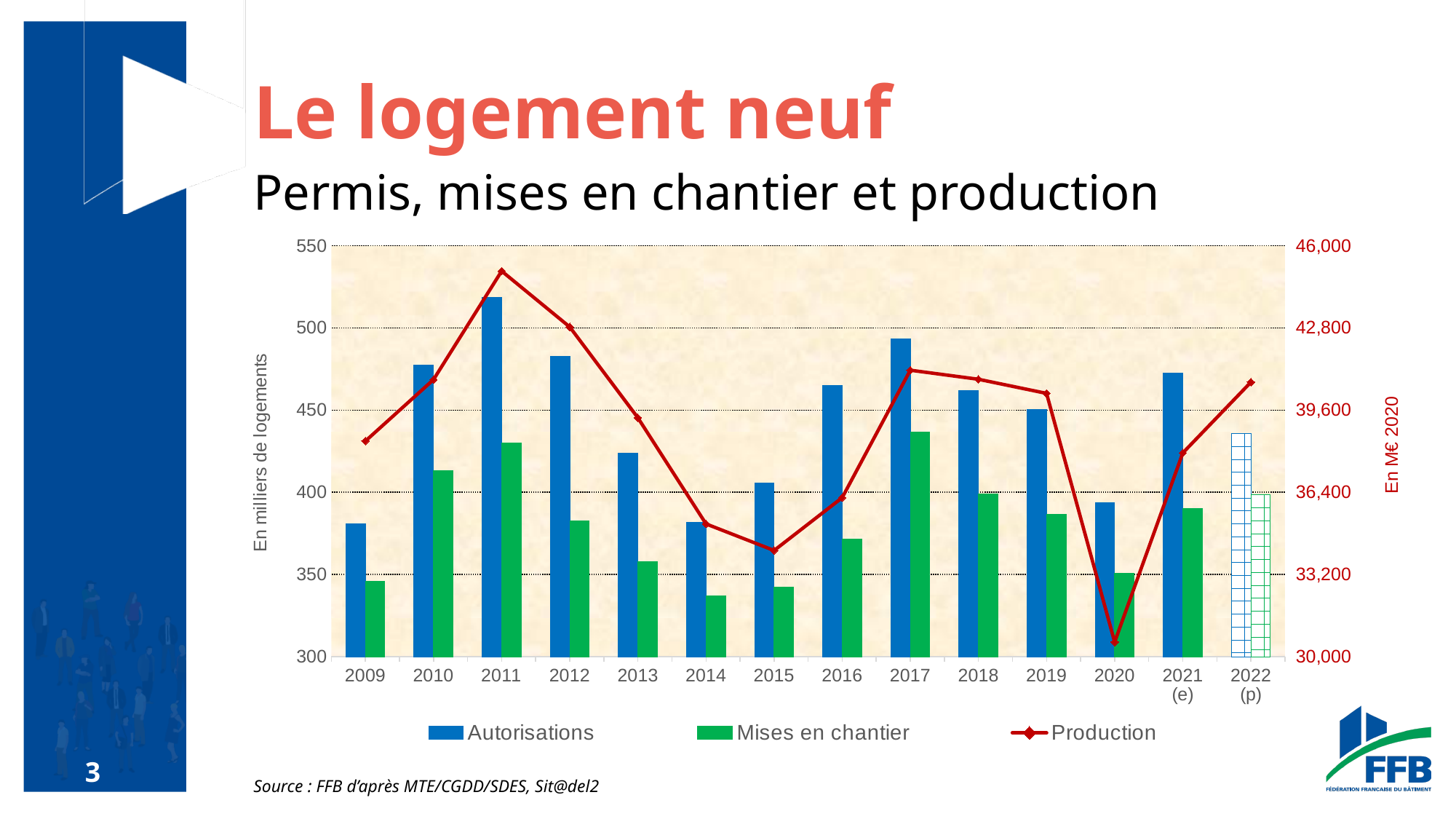
In which year is the Production line at its highest? 2011 What kind of chart is this? Combined bar and line chart In which year is the Production line at its lowest? 2020 How many years are shown on the x axis? 14 In which year is the Autorisations bar highest? 2011 Does the Production line rise or fall from 2017 to 2020? Fall Is the Production value for 2020 greater or less than 33,200? less Is the Mises en chantier value for 2009 greater or less than 350? less How many series does the legend list? 3 What is the label of the left vertical axis? En milliers de logements Is the Autorisations value for 2011 greater or less than 500? greater Which is larger, the Autorisations value for 2010 or for 2013? 2010